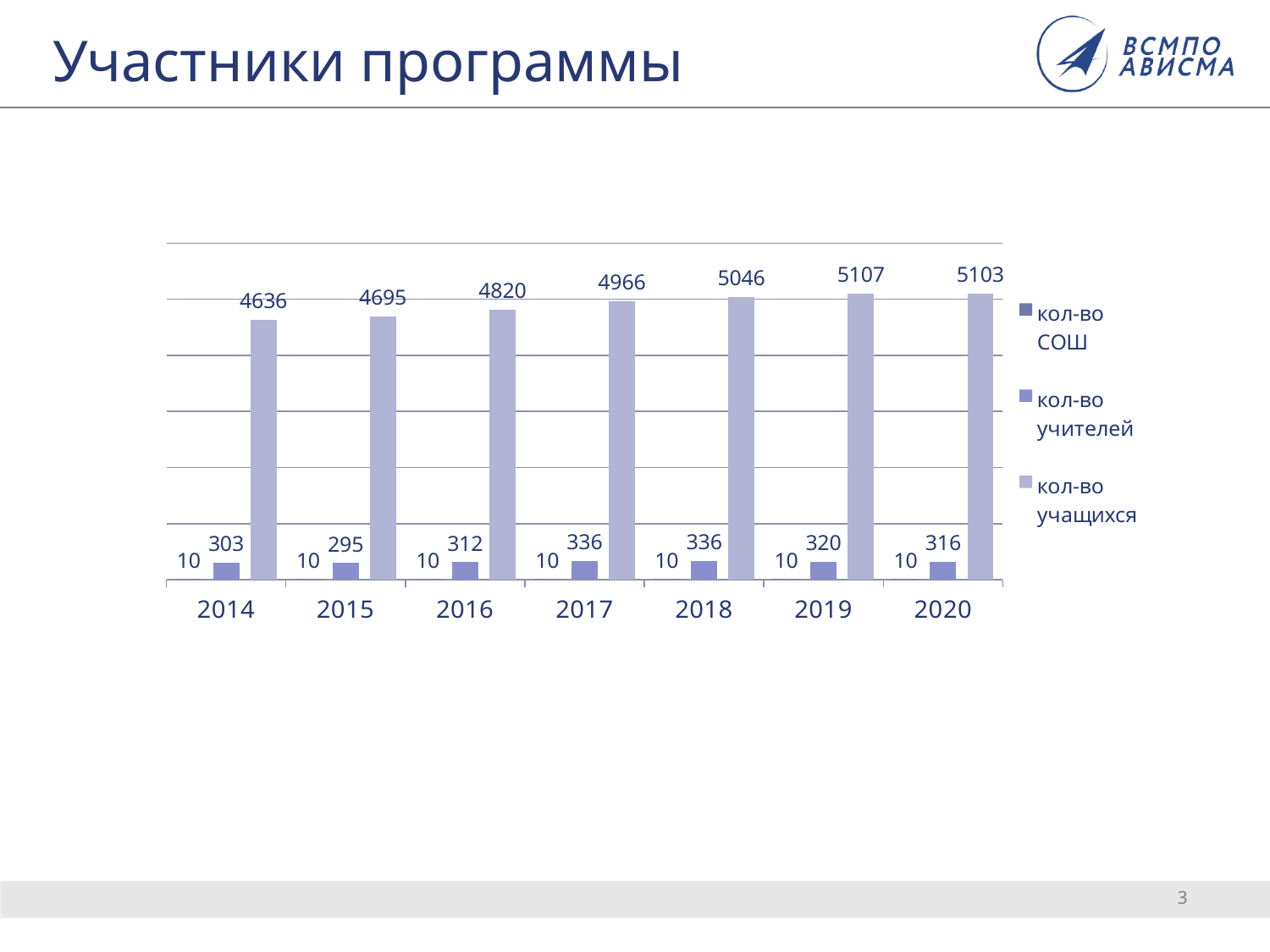
How many years are shown on the x axis? 7 What is the value for кол-во учителей in 2015? 295 What is the value for кол-во СОШ in 2020? 10 How many series does the legend list? 3 What is the value for кол-во учащихся in 2017? 4966 What kind of chart is shown on the slide? bar chart Does кол-во учащихся rise or fall from 2014 to 2019? rise What is the difference between кол-во учащихся in 2020 and in 2014? 467 In which year is кол-во учащихся highest? 2019 Which is larger: кол-во учителей in 2016 or in 2019? 2019 In which year is кол-во учителей lowest? 2015 What is the title of the slide? Участники программы